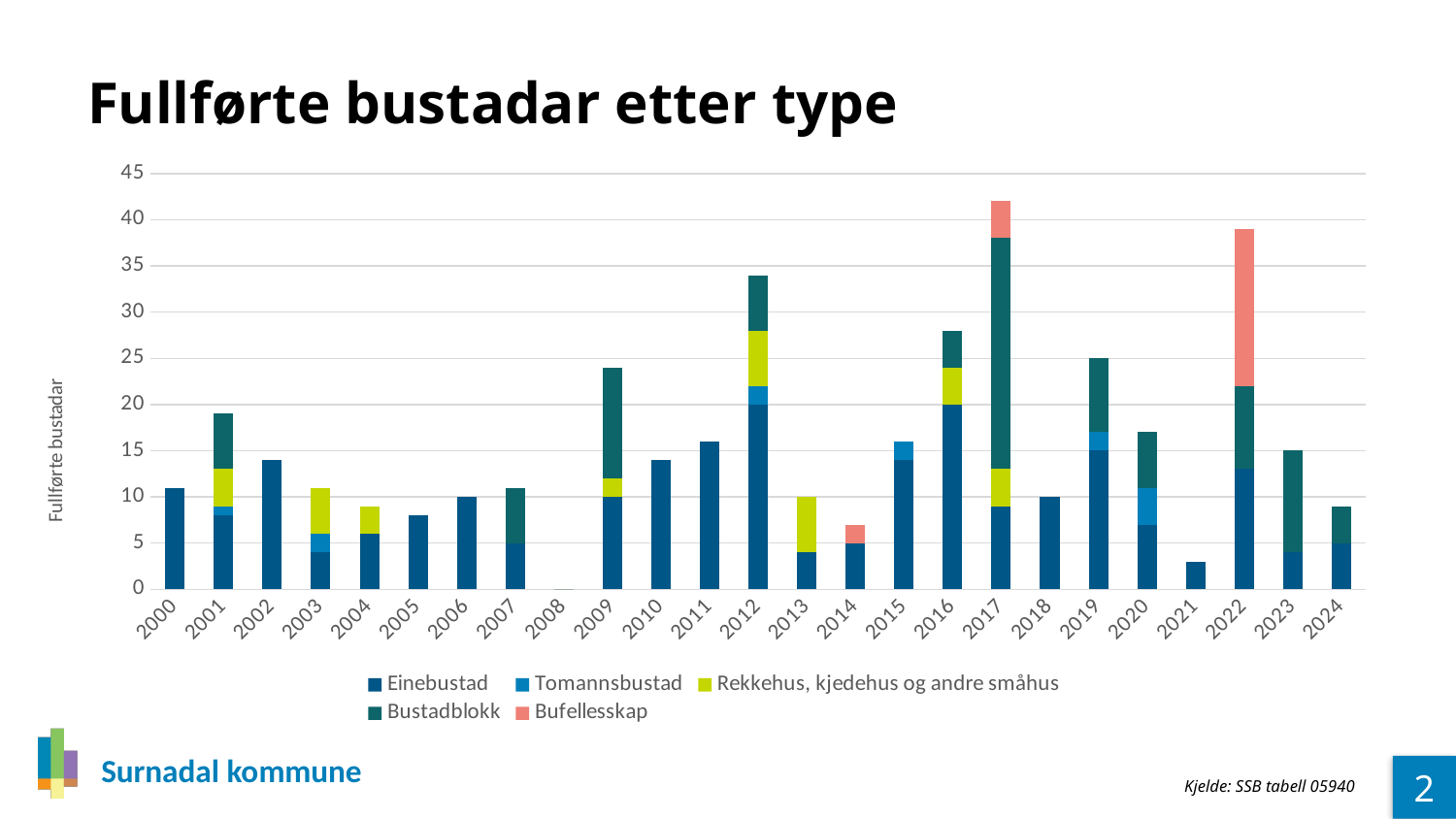
Is the total for 2023 greater or less than 20? less What kind of chart is shown on the slide? bar chart How many series does the legend list? 5 Is the total for 2009 greater or less than 20? greater What source is cited for the chart data? SSB tabell 05940 Which year has the lowest total of completed dwellings? 2008 What is the title of the chart? Fullførte bustadar etter type Is the total for 2012 greater or less than 30? greater How many years are shown along the x axis? 25 Which year has the larger total, 2012 or 2016? 2012 Which year has the tallest stacked bar? 2017